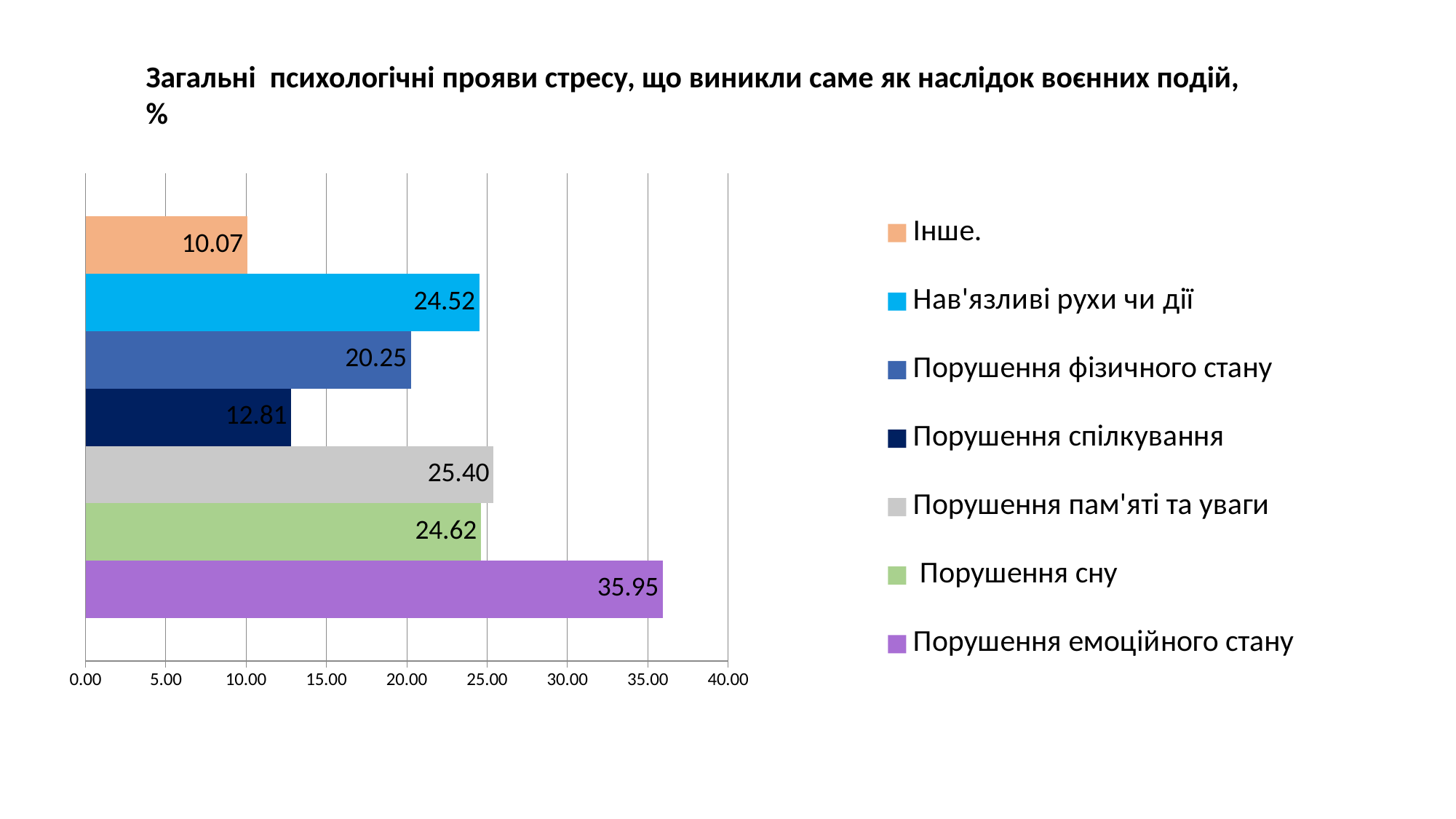
What colour is the bar for Порушення пам'яті та уваги? grey What is the value for Порушення спілкування? 12.81 Which is larger, the value for Порушення фізичного стану or the value for Порушення спілкування? Порушення фізичного стану What is the difference between the values for Нав'язливі рухи чи дії and Порушення фізичного стану? 4.27 What is the value for Нав'язливі рухи чи дії? 24.52 Is the value for Порушення сну greater or less than 20.00? greater What is the value for Порушення емоційного стану? 35.95 What is the difference between the values for Порушення емоційного стану and Інше.? 25.88 Which category has the lowest value? Інше. How many series does the legend list? 7 Which category has the highest value? Порушення емоційного стану What kind of chart is shown on the slide? bar chart